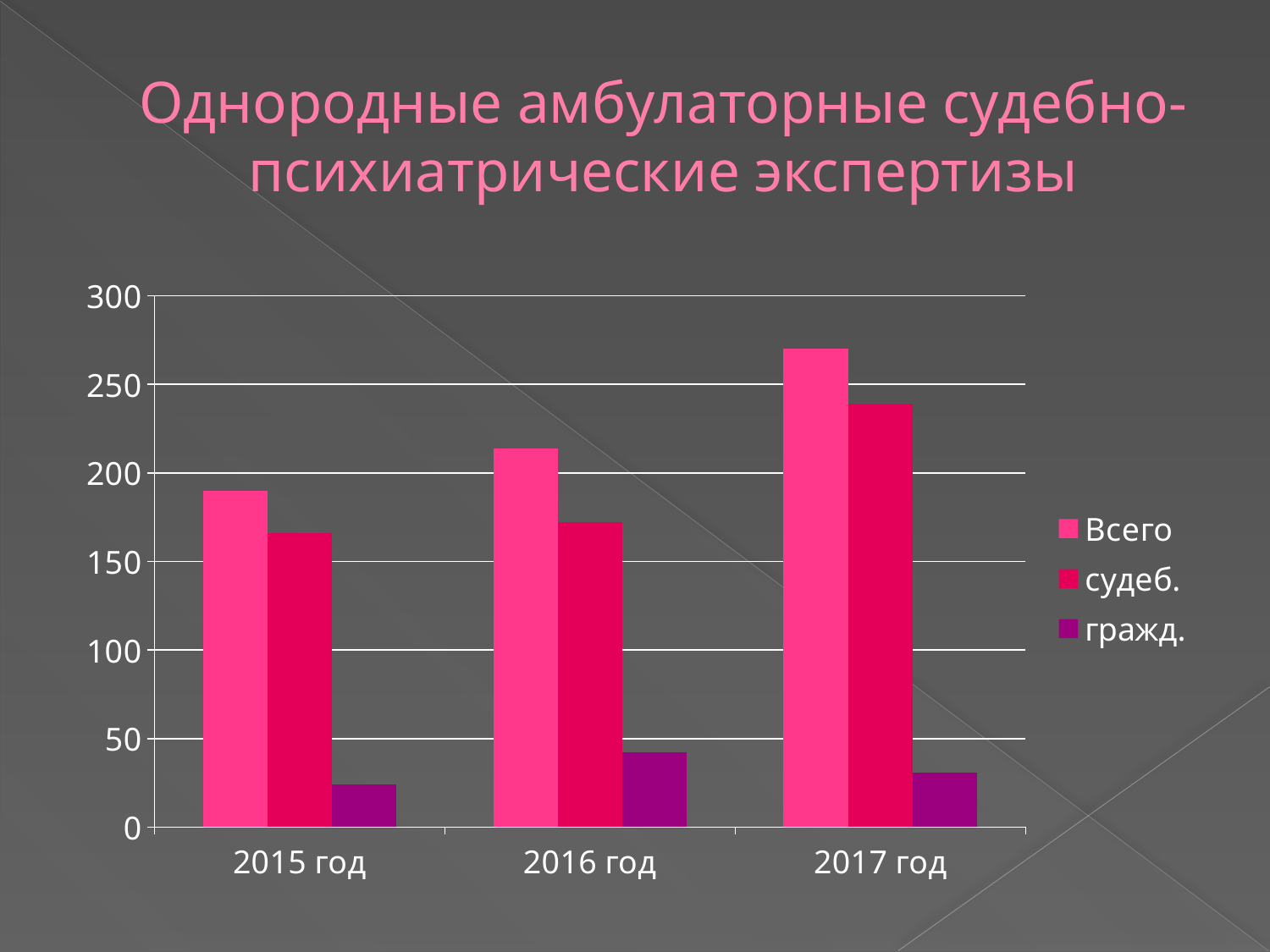
What is the title of the chart on the slide? Однородные амбулаторные судебно-психиатрические экспертизы How many series does the legend list? 3 Which year has the lowest value for гражд.? 2015 год Is the value for гражд. in 2016 год greater or less than 50? less Which year has the highest value for Всего? 2017 год Which is larger: гражд. in 2016 год or гражд. in 2017 год? гражд. in 2016 год Which year has the highest value for судеб.? 2017 год How many year categories are shown on the x axis? 3 Is the value for судеб. in 2015 год greater or less than 150? greater What kind of chart is shown on the slide? bar chart Is the value for Всего in 2017 год greater or less than 250? greater Does the value for Всего rise or fall from 2015 год to 2017 год? rise